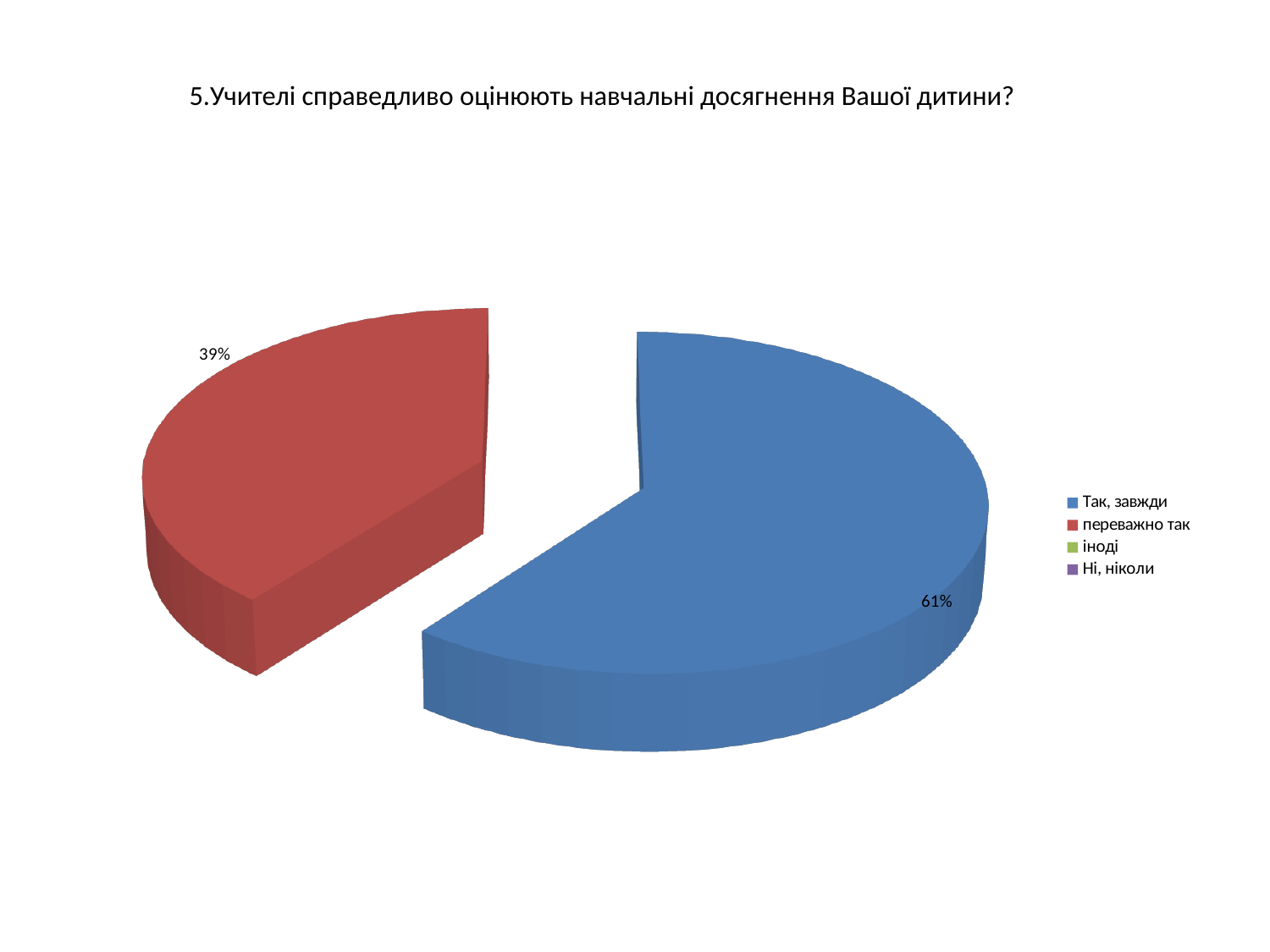
What kind of chart is shown on the slide? Pie chart What share of the pie does the "переважно так" slice represent? 39% Which category has the largest slice of the pie? Так, завжди Is the share for "Так, завжди" greater or less than 50%? greater What colour is the "переважно так" slice? Red How many entries does the legend list? 4 Which of the two visible slices is larger, "Так, завжди" or "переважно так"? Так, завжди What is the difference in percentage points between the "Так, завжди" and "переважно так" slices? 22 What share of the pie does the "Так, завжди" slice represent? 61% How many slices are visible in the pie? 2 What is the title of the chart? 5.Учителі справедливо оцінюють навчальні досягнення Вашої дитини?